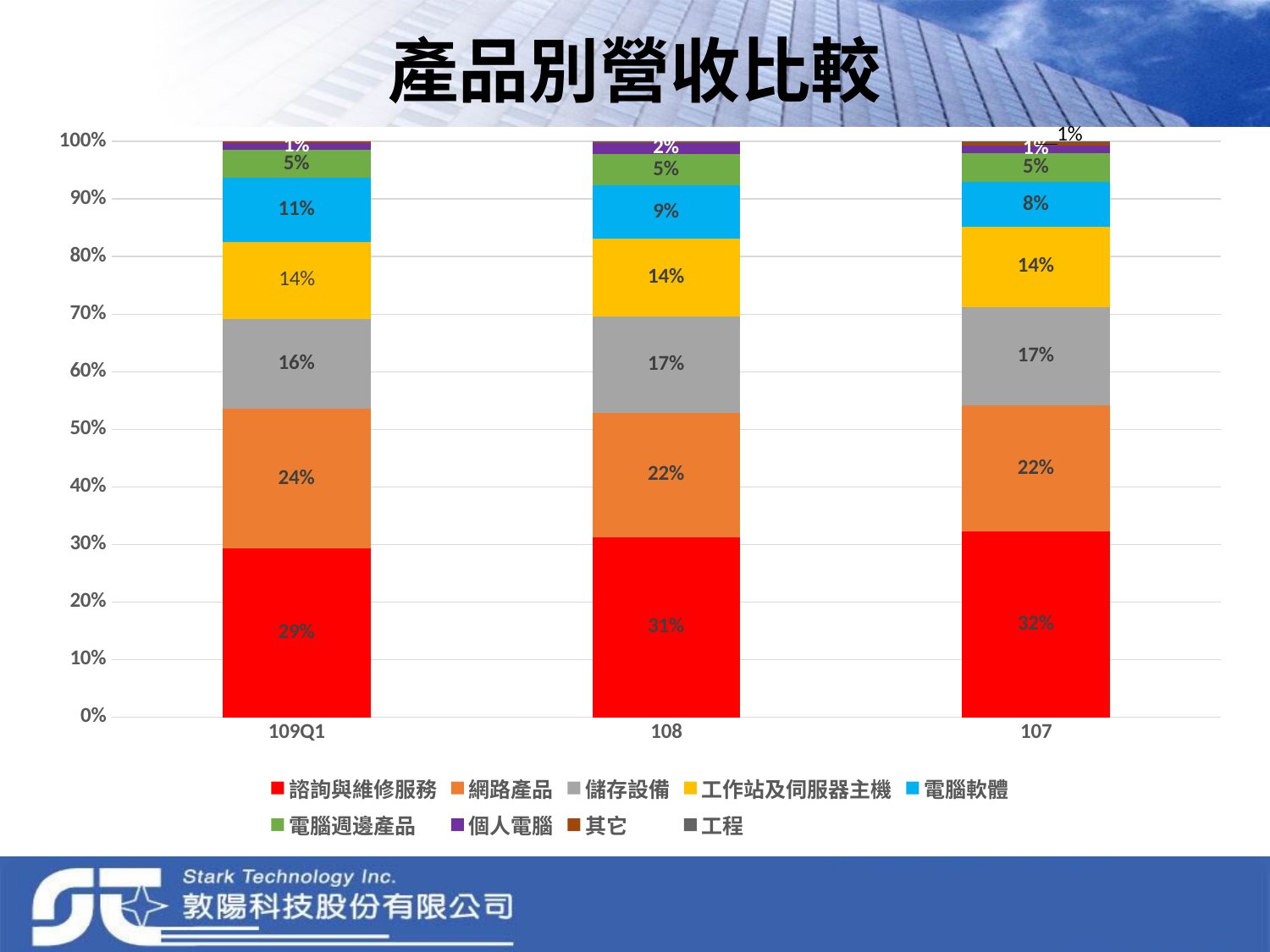
What is the value for 儲存設備 in 109Q1? 16% What is the value for 網路產品 in 108? 22% Which period has the lowest value for 電腦軟體? 107 What is the value for 電腦軟體 in 107? 8% Does the value for 諮詢與維修服務 rise or fall from 107 to 109Q1 along the x axis? fall How many categories are shown on the x axis? 3 What is the difference between the 網路產品 value in 109Q1 and in 108? 2% How many series does the legend list? 9 Which period has the highest value for 諮詢與維修服務? 107 What is the title of the chart? 產品別營收比較 What is the value for 諮詢與維修服務 in 109Q1? 29% What kind of chart is shown on the slide? stacked bar chart